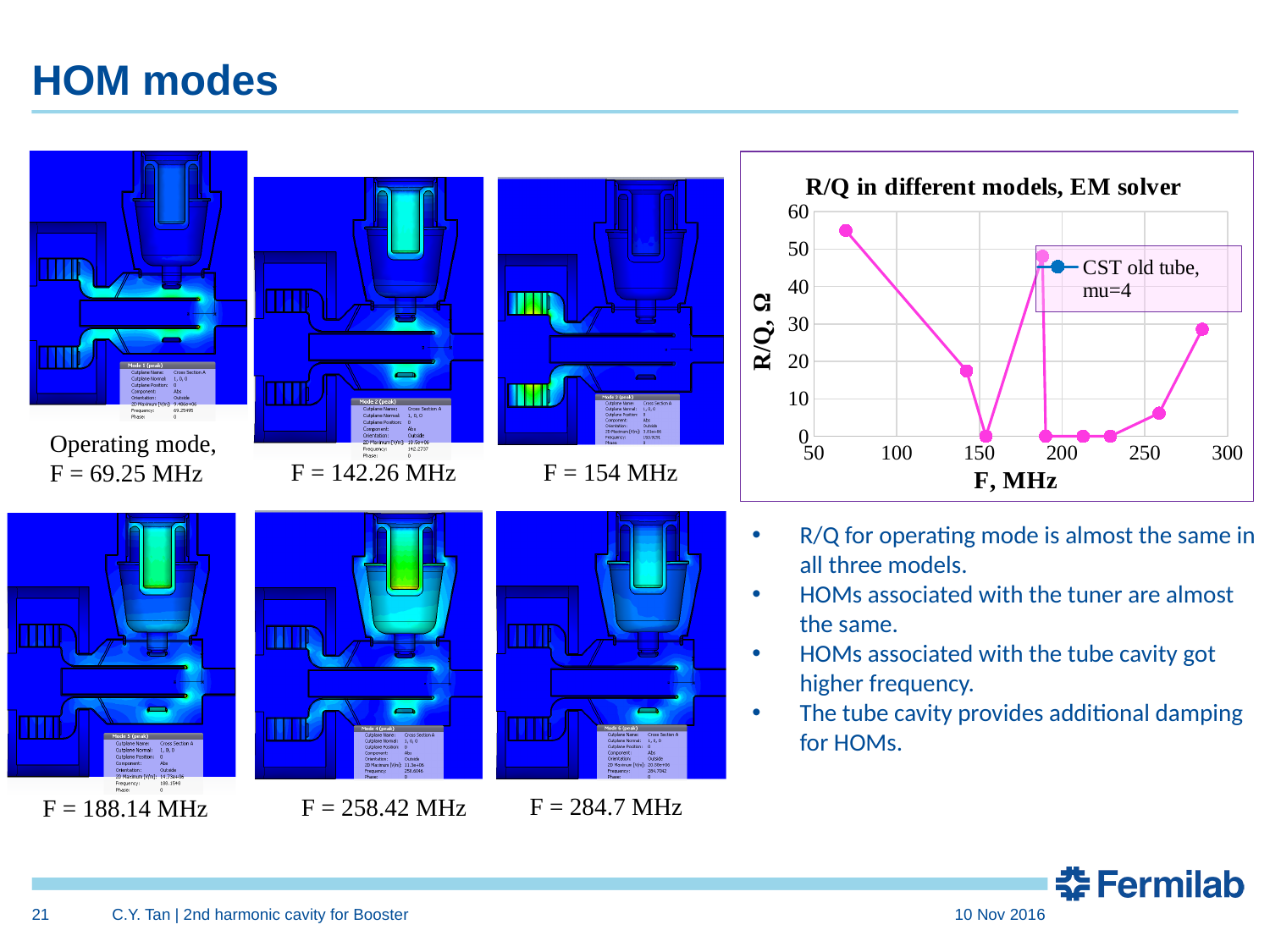
Do the R/Q values rise or fall as frequency increases from 50 MHz to 150 MHz? fall What type of chart is shown on the slide? line chart Is the R/Q value of the data point near 142 MHz greater or less than 20? less What is the name of the series shown in the chart legend? CST old tube, mu=4 Is the R/Q value of the data point near 258 MHz greater or less than 10? less How many series does the chart legend list? 1 How many data points are plotted on the chart? 9 Which has the larger R/Q: the data point near 70 MHz or the data point near 188 MHz? the data point near 70 MHz Is the R/Q value of the first data point (near 70 MHz) greater or less than 50? greater Do the R/Q values rise or fall as frequency increases from 230 MHz to 300 MHz? rise What is the title of the chart on the slide? R/Q in different models, EM solver